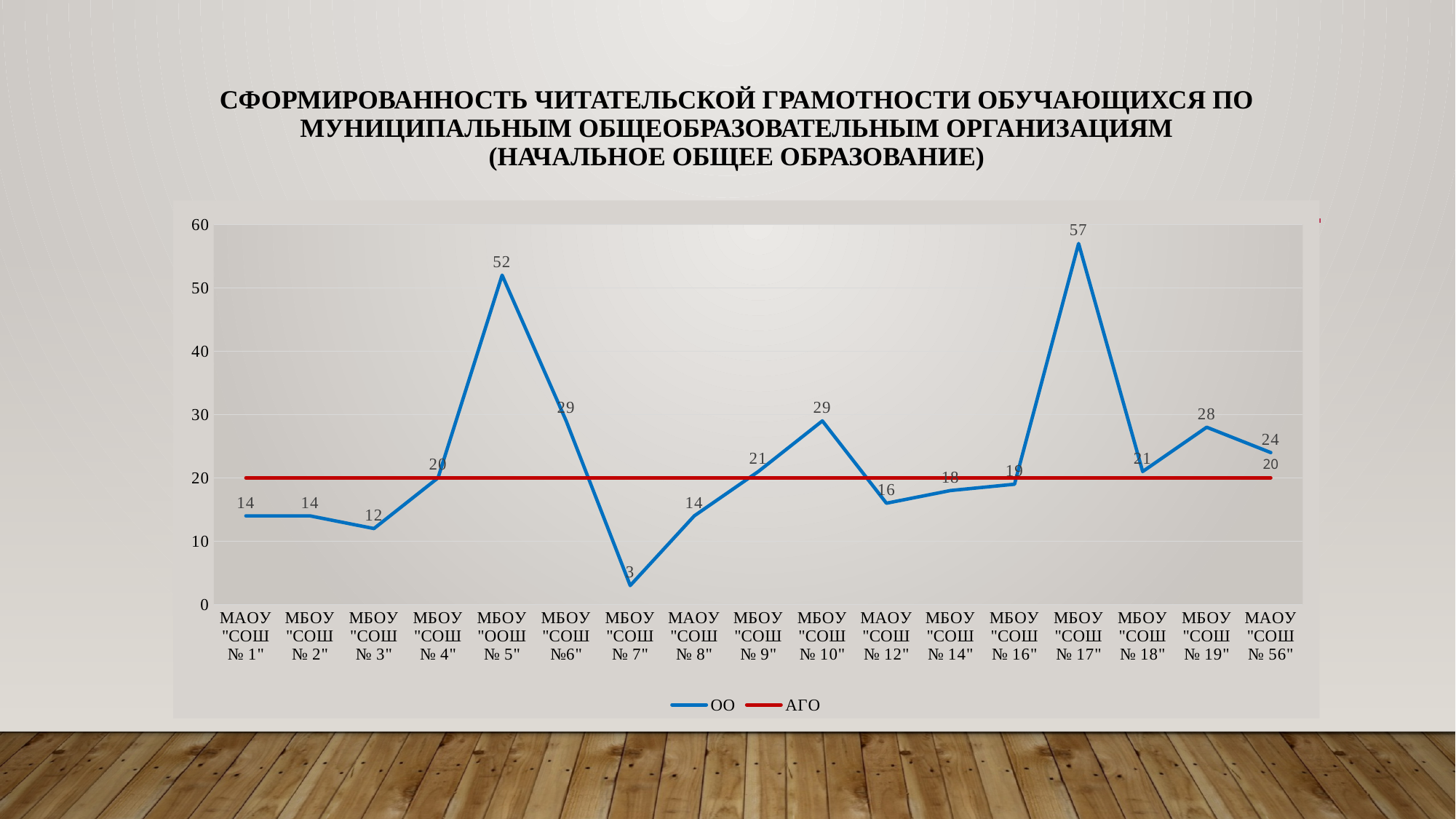
Which has a larger ОО value, МБОУ "СОШ № 10" or МАОУ "СОШ № 12"? МБОУ "СОШ № 10" What is the ОО value for МБОУ "СОШ № 19"? 28 Which school has the lowest ОО value? МБОУ "СОШ № 7" What is the difference between the ОО values for МБОУ "СОШ № 17" and МБОУ "ООШ № 5"? 5 What is the ОО value for МБОУ "СОШ № 7"? 3 What colour is the АГО line in the chart? red What is the ОО value for МБОУ "ООШ № 5"? 52 How many schools (categories) are plotted along the x axis? 17 How many series does the legend list? 2 Which school has the highest ОО value? МБОУ "СОШ № 17" Is the ОО value for МБОУ "СОШ № 3" greater or less than 20? less What type of chart is shown on the slide? line chart